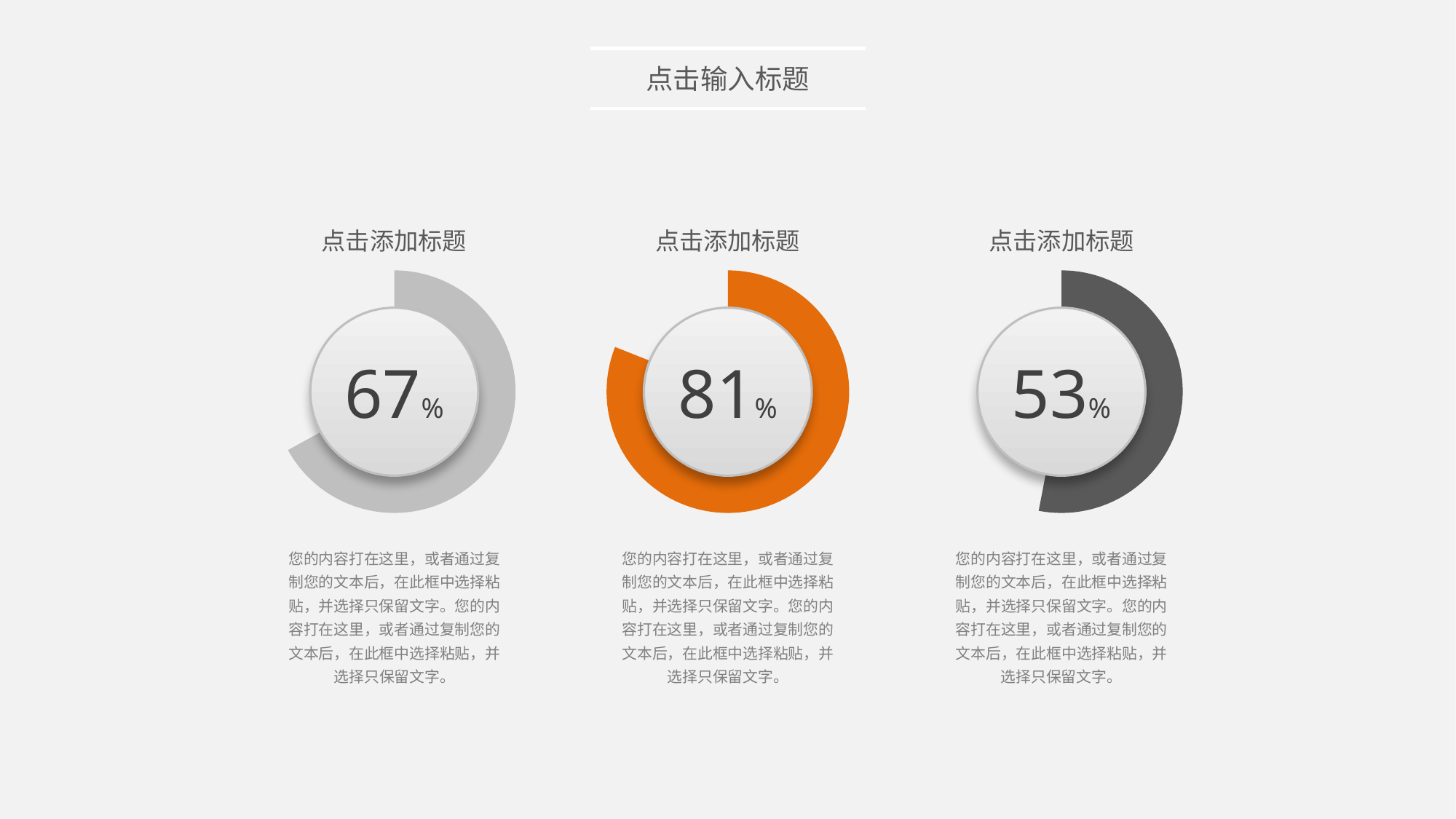
What is the difference between the left chart's value and the right chart's value? 14% What kind of chart is used to display the percentages on the slide? Ring (donut) progress chart Which of the three ring charts shows the lowest percentage? The right chart (53%) What is the difference between the middle chart's value and the left chart's value? 14% What colour is the ring of the right chart? Dark grey What value is shown in the left ring chart? 67% What value is shown in the middle ring chart? 81% Which is larger, the value in the left chart or the value in the right chart? The left chart (67%) What colour is the ring of the middle chart? Orange How many ring charts are shown on the slide? 3 What value is shown in the right ring chart? 53% Which of the three ring charts shows the highest percentage? The middle chart (81%)